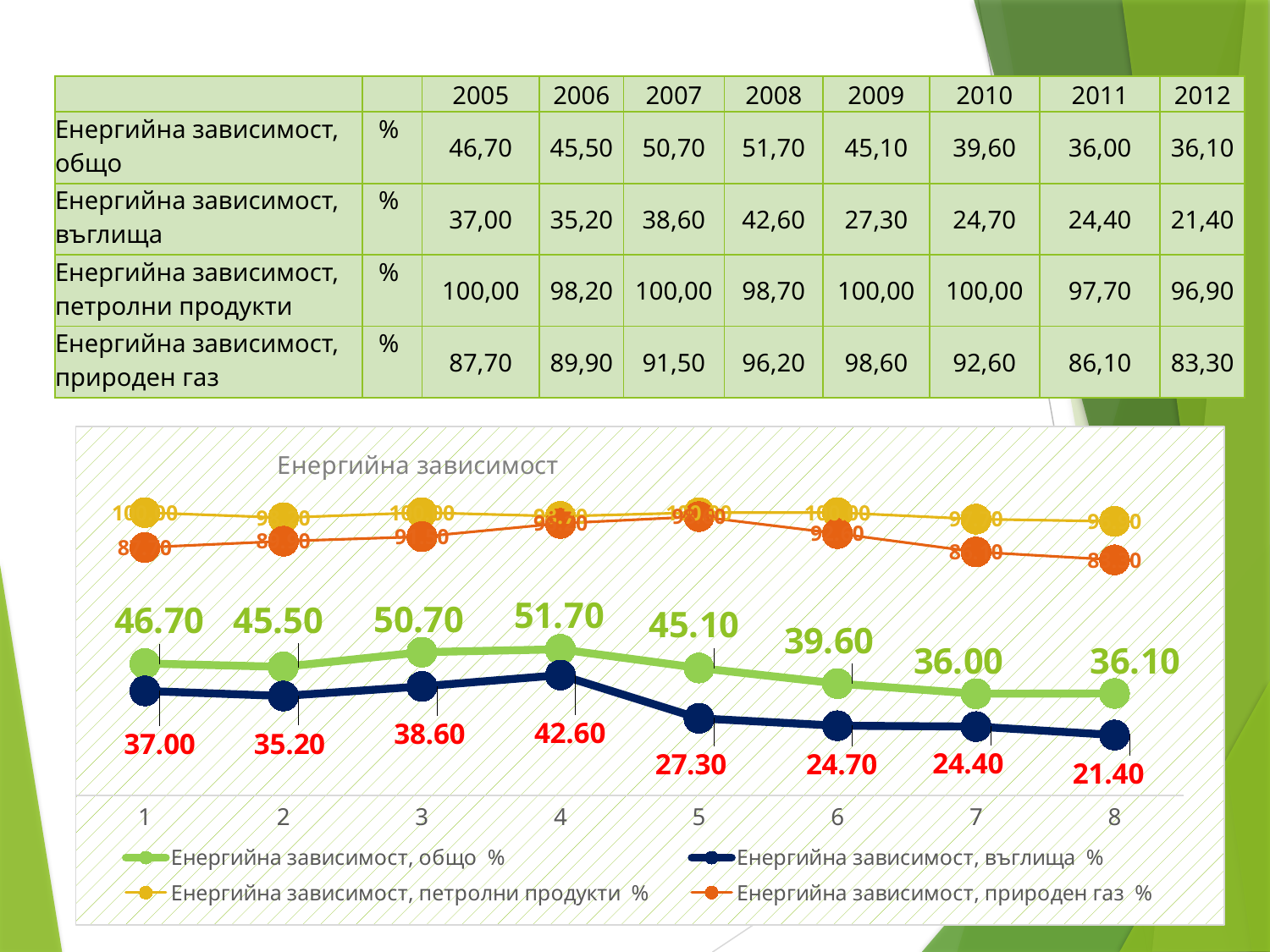
What is the title of the chart? Енергийна зависимост How many series does the chart legend list? 4 Does the series "Енергийна зависимост, въглища %" rise or fall from point 4 to point 8? Fall How many points are plotted along the x axis of the chart? 8 At which x-axis point does the series "Енергийна зависимост, въглища %" reach its lowest value? 8 What colour is the line for "Енергийна зависимост, петролни продукти %" in the chart? Yellow What is the value of the series "Енергийна зависимост, общо %" at point 4 on the chart? 51.70 For the series "Енергийна зависимост, общо %", which is larger: the value at point 3 or the value at point 5? Point 3 At which x-axis point does the series "Енергийна зависимост, общо %" reach its highest value? 4 At point 1, what is the difference between the "Енергийна зависимост, общо %" value and the "Енергийна зависимост, въглища %" value? 9.70 What kind of chart is shown on the slide? Line chart What is the value of the series "Енергийна зависимост, въглища %" at point 8 on the chart? 21.40